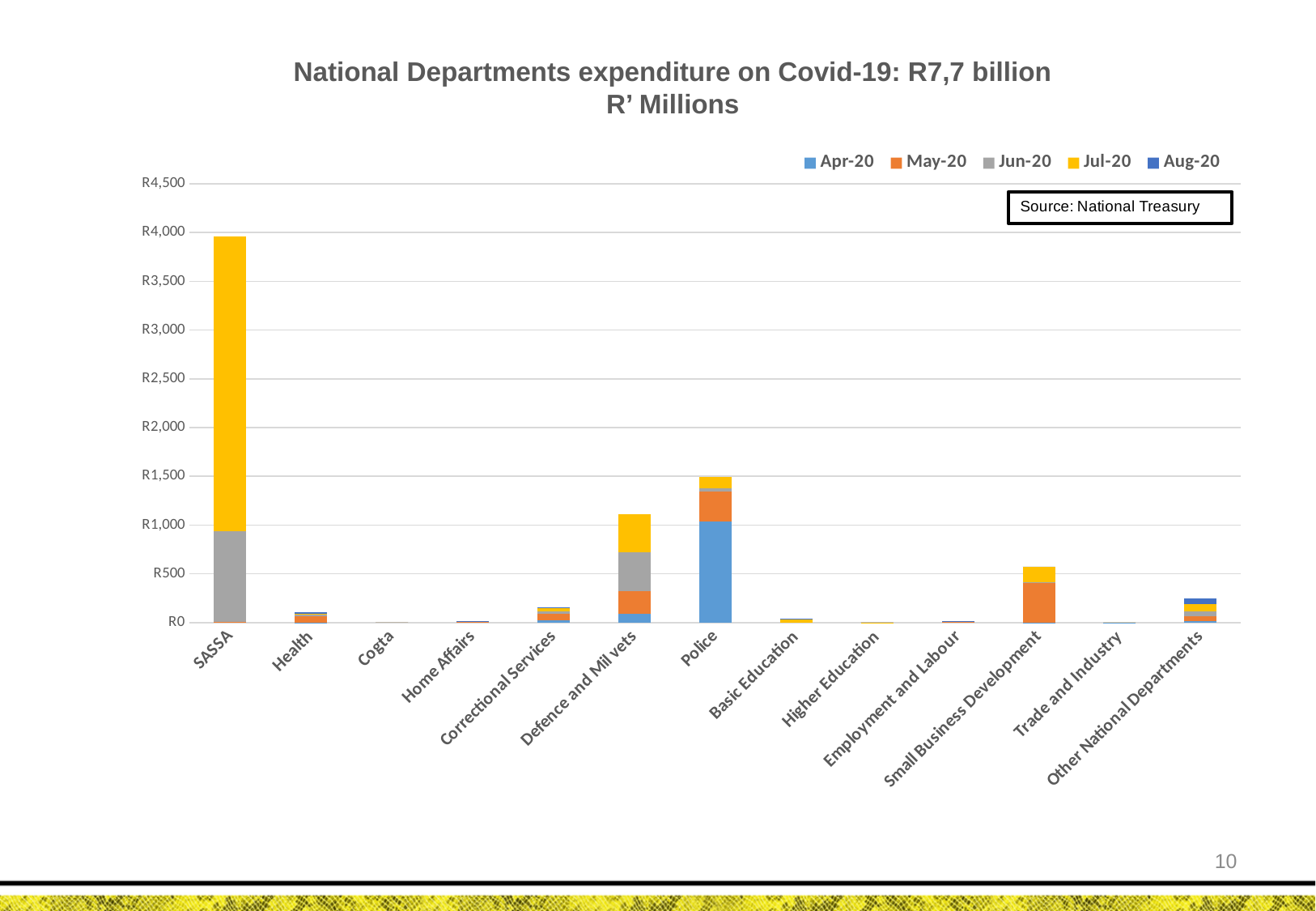
What source is cited for the chart data? National Treasury Is the total value for Police greater or less than R1,000? greater Is the total value for Small Business Development greater or less than R1,000? less What is the title of the chart? National Departments expenditure on Covid-19: R7,7 billion R' Millions Which has the larger total bar, Police or Defence and Mil vets? Police Is the total value for Defence and Mil vets greater or less than R500? greater How many series does the legend list? 5 How many departments (categories) are shown along the x axis? 13 Which department has the highest total Covid-19 expenditure? SASSA Which has the larger total bar, Health or Small Business Development? Small Business Development What kind of chart is shown on the slide? Stacked bar chart